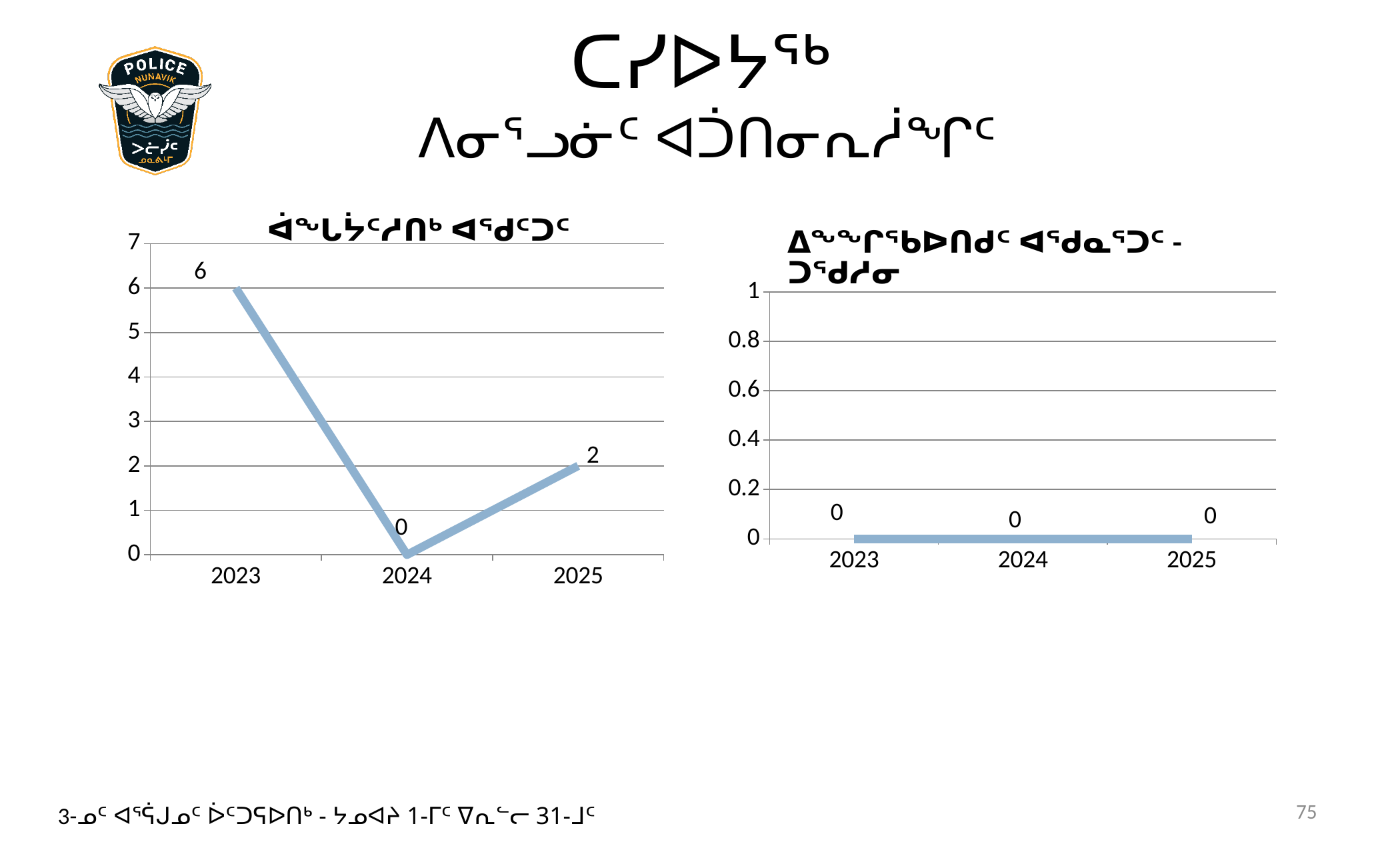
In the left chart, what is the value for 2025? 2 In the left chart, what is the value for 2024? 0 In the left chart, is the value for 2023 greater or less than 5? greater How many years are plotted on the x axis of the right chart? 3 In the left chart, what is the difference between the values for 2023 and 2025? 4 What kind of chart is the left chart? line chart In the right chart, what is the value for 2024? 0 In the left chart, which year has the lowest value? 2024 In the left chart, which is larger, the value for 2023 or the value for 2025? 2023 In the left chart, what is the value for 2023? 6 In the left chart, which year has the highest value? 2023 In the left chart, does the value rise or fall from 2024 to 2025? rise